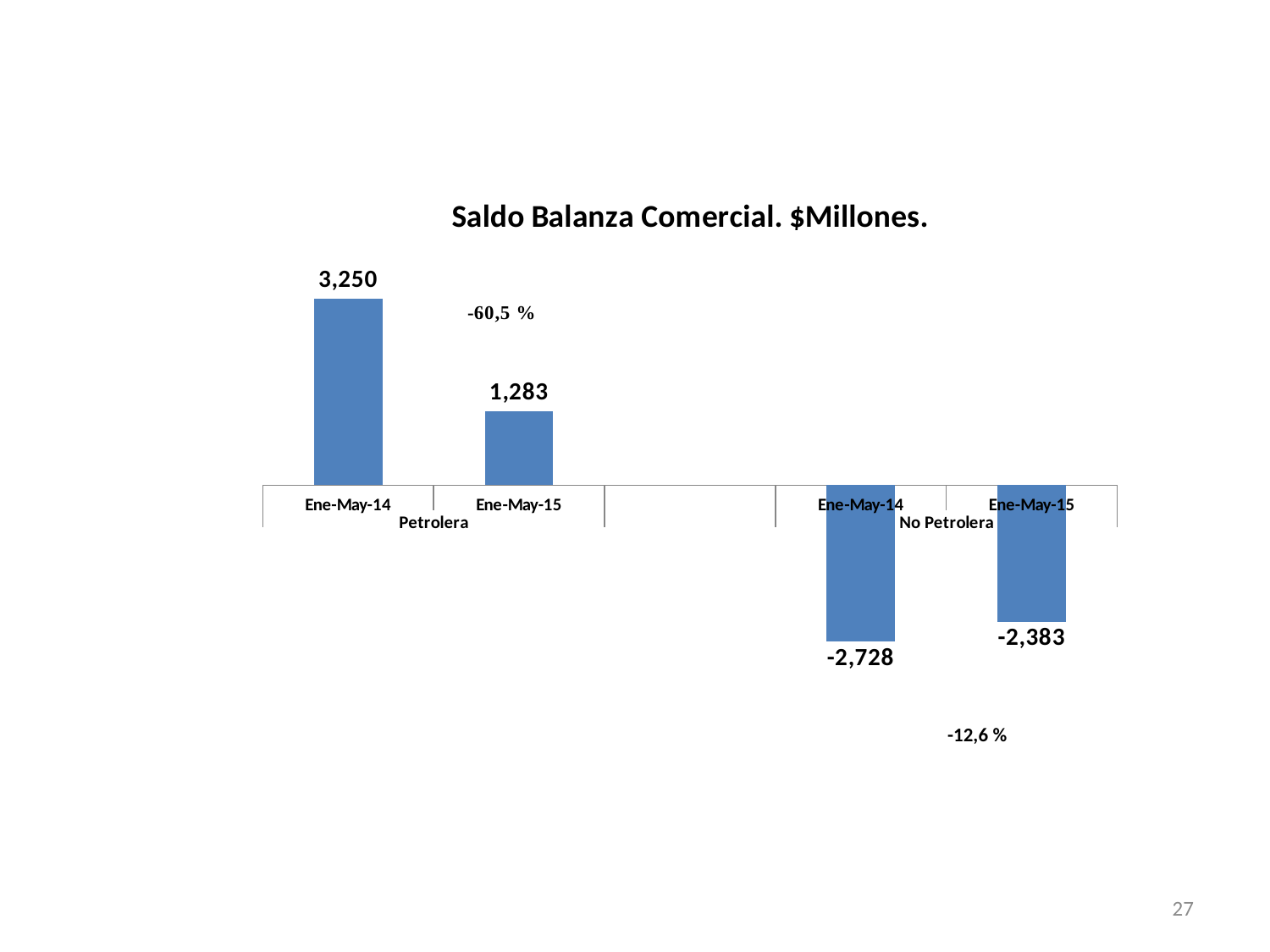
What is the value for Petrolera Ene-May-15? 1,283 What percentage change is annotated for the Petrolera group? -60,5 % How many bars are plotted in the chart? 4 What is the title of the chart? Saldo Balanza Comercial. $Millones. Which bar has the lowest value? No Petrolera Ene-May-14 Which bar has the highest value? Petrolera Ene-May-14 What kind of chart is shown? Bar chart Which is larger, the Petrolera value for Ene-May-14 or for Ene-May-15? Ene-May-14 What is the value for No Petrolera Ene-May-15? -2,383 What is the value for No Petrolera Ene-May-14? -2,728 What is the value for Petrolera Ene-May-14? 3,250 What is the difference between the Petrolera values for Ene-May-14 and Ene-May-15? 1,967